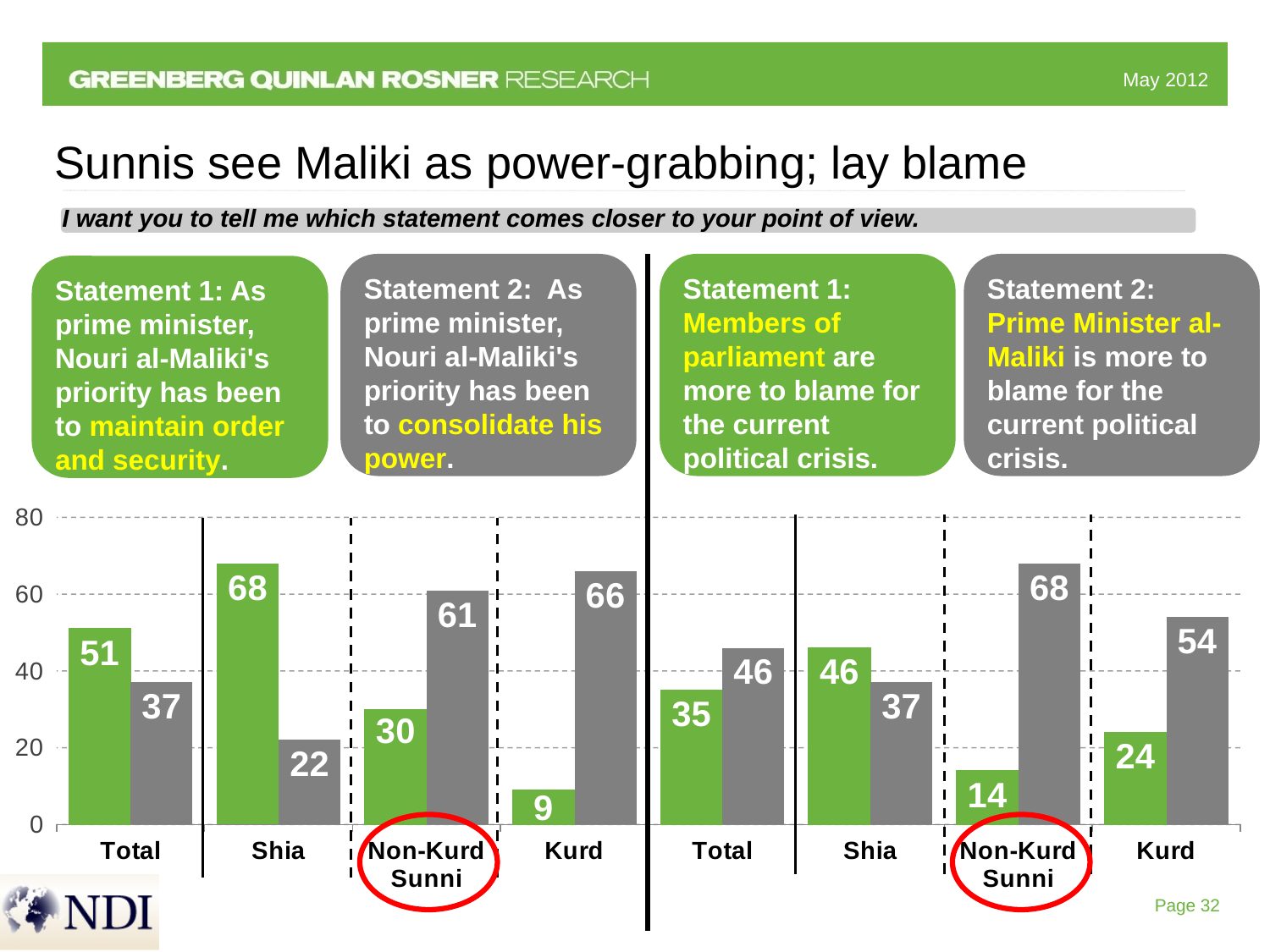
In the left chart (Maliki's priority), is the green bar for Total greater or less than 40? greater In the left chart (Maliki's priority), what is the difference between the grey bar and the green bar for Kurd? 57 In the right chart (blame for the political crisis), what is the difference between the grey bar and the green bar for Non-Kurd Sunni? 54 What kind of chart is used on this slide? Bar chart In the right chart (blame for the political crisis), what is the value of the green bar (Statement 1: Members of parliament) for Total? 35 In the right chart (blame for the political crisis), which group has the highest grey bar (Statement 2: Prime Minister al-Maliki)? Non-Kurd Sunni In the left chart (Maliki's priority), what is the value of the green bar (Statement 1: maintain order and security) for Shia? 68 In the left chart (Maliki's priority), which group has the lowest green bar (Statement 1: maintain order and security)? Kurd In the right chart (blame for the political crisis), what is the value of the grey bar (Statement 2: Prime Minister al-Maliki) for Kurd? 54 In the left chart (Maliki's priority), what is the value of the grey bar (Statement 2: consolidate his power) for Non-Kurd Sunni? 61 How many groups are shown on the x axis of the left chart (Maliki's priority)? 4 In the right chart (blame for the political crisis), for Shia, which is larger: the green bar (Statement 1) or the grey bar (Statement 2)? The green bar (Statement 1), 46